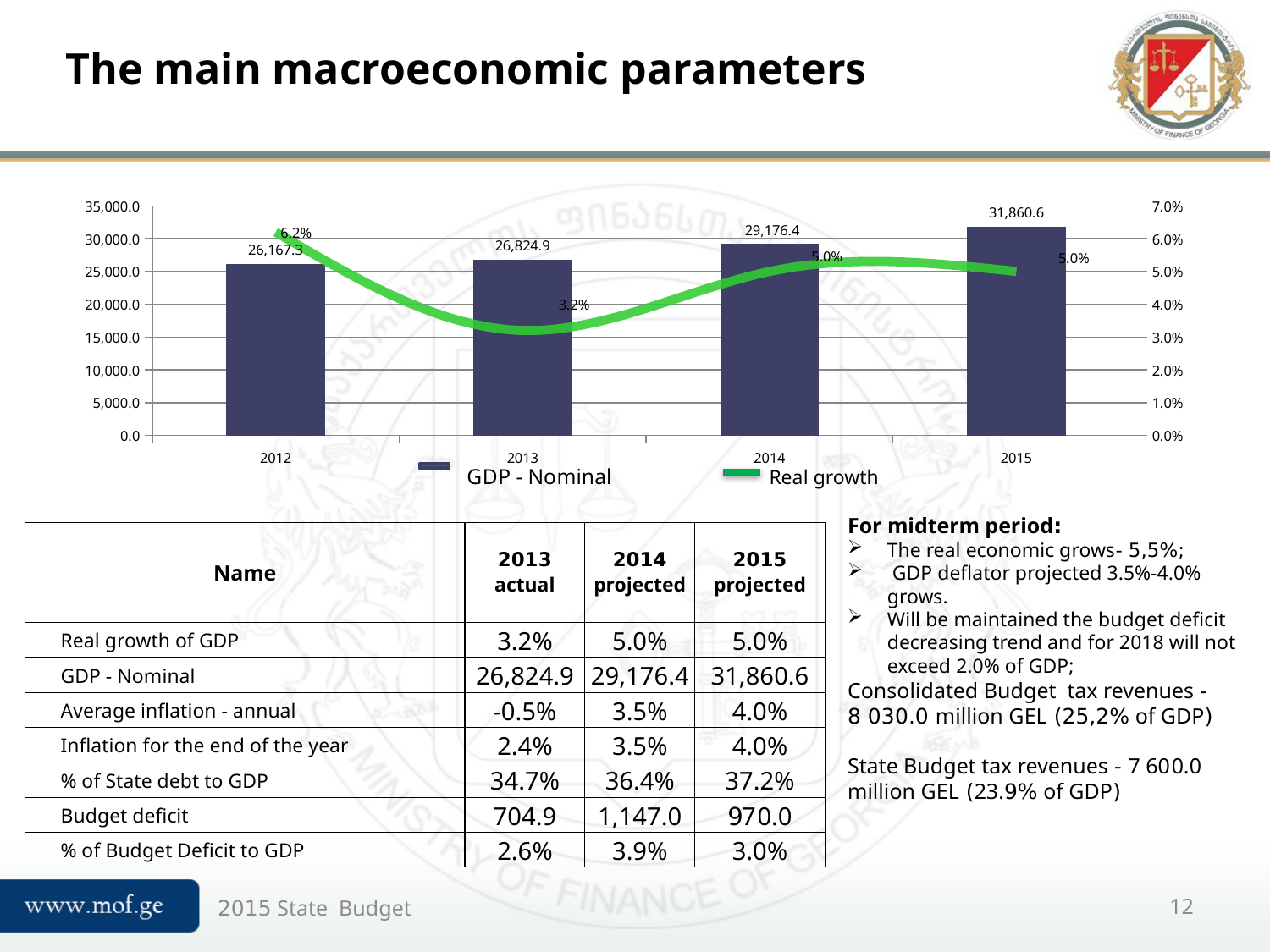
How many years are shown on the x axis of the chart? 4 Which is larger in the chart: GDP - Nominal for 2013 or for 2014? 2014 What is the difference between GDP - Nominal in 2015 and 2014 in the chart? 2,684.2 Does GDP - Nominal rise or fall from 2012 to 2015 in the chart? rise What is the Real growth value for 2013 in the chart? 3.2% Which year has the lowest Real growth in the chart? 2013 What is the GDP - Nominal value for 2015 in the chart? 31,860.6 What is the GDP - Nominal value for 2012 in the chart? 26,167.3 Is the GDP - Nominal value for 2015 greater or less than 30,000.0? greater How many series does the chart legend list? 2 What is the Real growth value for 2012 in the chart? 6.2% Which year has the highest GDP - Nominal in the chart? 2015